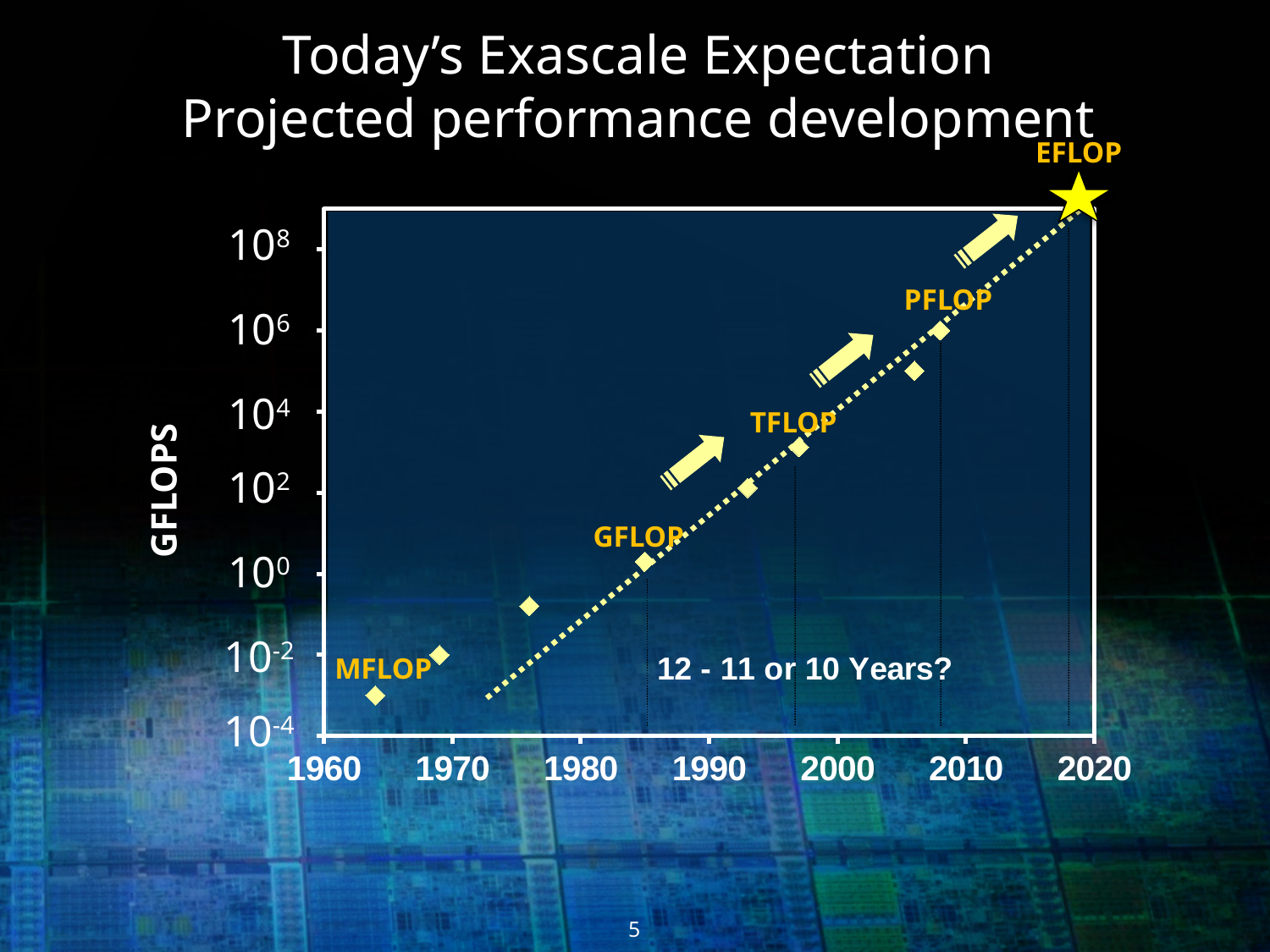
Is the value of the MFLOP point (around 1964) greater or less than 10^0? less Do the plotted performance values rise or fall as the years increase along the x axis? rise Is the value of the GFLOP point (around 1985) greater or less than 10^2? less Is the TFLOP point higher or lower than the GFLOP point? higher What are the first and last year labels on the x axis? 1960 and 2020 How many milestone labels (MFLOP, GFLOP, etc.) are shown on the chart? 5 What kind of chart is shown on the slide? scatter chart What is the label on the y axis of the chart? GFLOPS What question is written as an annotation inside the chart area? 12 - 11 or 10 Years? Which milestone label marks the lowest point on the chart? MFLOP Which milestone label marks the highest point on the chart? EFLOP Is the value of the PFLOP point (around 2008) greater or less than 10^4? greater